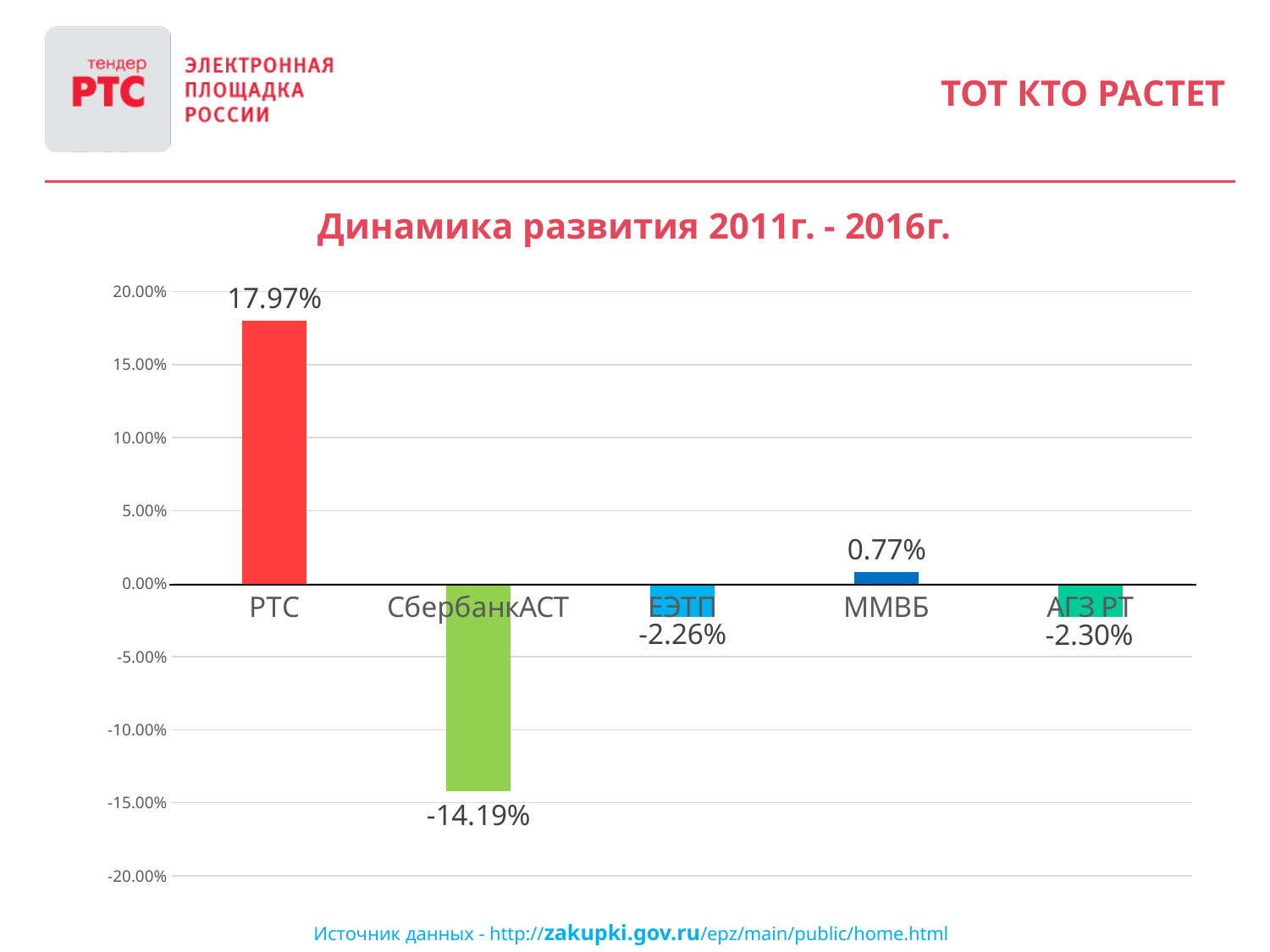
Which category has the lowest value? СбербанкАСТ Which is larger, the value for ММВБ or the value for ЕЭТП? ММВБ What is the difference between the values for РТС and ММВБ? 17.20% What is the title of the chart? Динамика развития 2011г. - 2016г. What is the value for РТС? 17.97% What kind of chart is shown on the slide? Bar chart How many categories are shown in the chart? 5 Which category has the highest value? РТС What is the value for ЕЭТП? -2.26% What is the value for СбербанкАСТ? -14.19% What is the value for АГЗ РТ? -2.30% What is the value for ММВБ? 0.77%